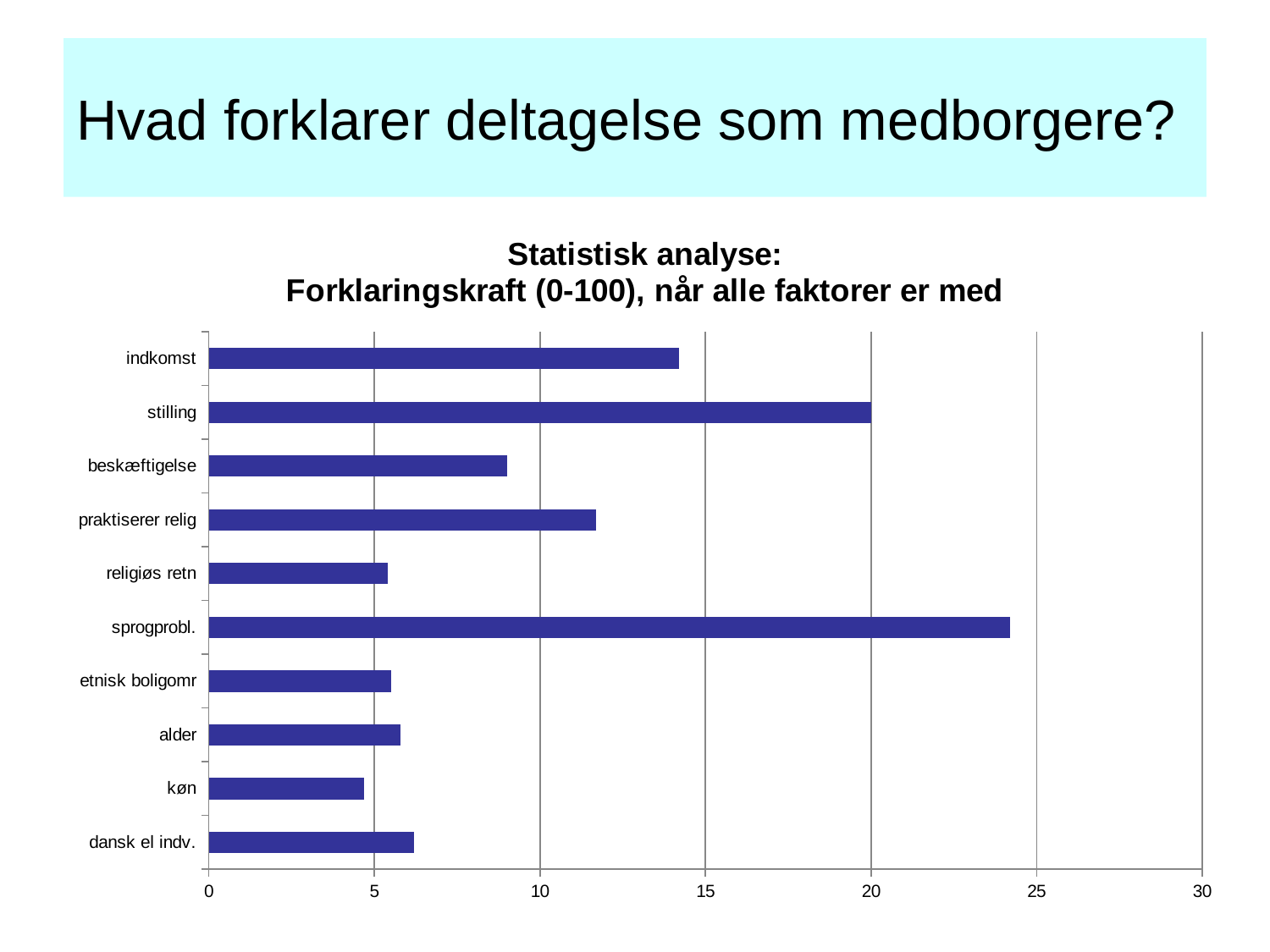
Which is larger, the value for praktiserer relig or the value for religiøs retn? praktiserer relig Which factor has the highest explanatory power in the chart? sprogprobl. What kind of chart is shown on the slide? bar chart Is the value for indkomst greater or less than 10? greater What is the value for stilling? 20 What is the title of the chart? Statistisk analyse: Forklaringskraft (0-100), når alle faktorer er med Is the value for køn greater or less than 5? less Is the value for beskæftigelse greater or less than 10? less Which is larger, the value for indkomst or the value for beskæftigelse? indkomst Which factor has the lowest explanatory power in the chart? køn How many factors (categories) are plotted in the chart? 10